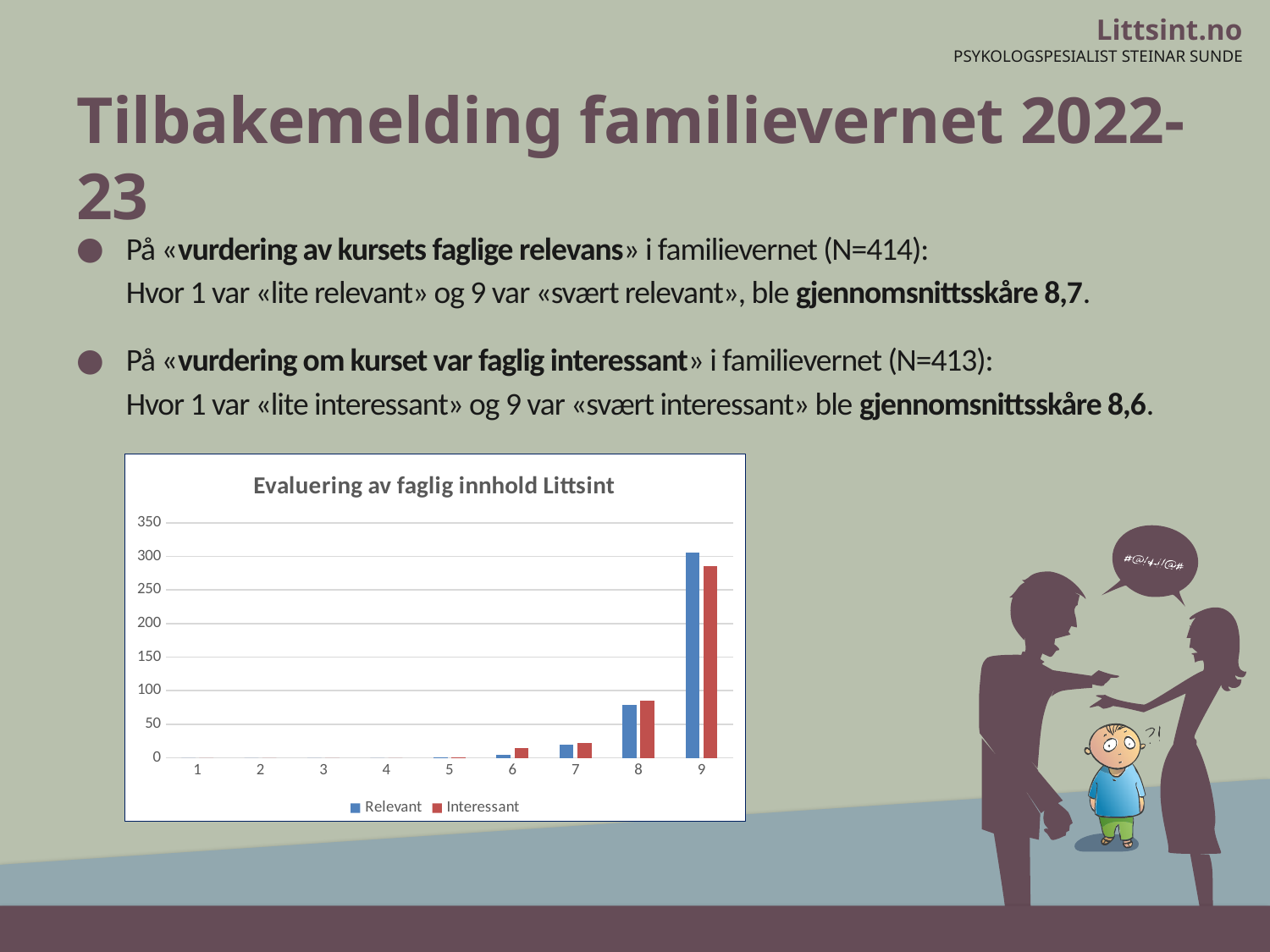
Do the values generally rise or fall as you move from category 1 to category 9? rise At category 6, which series has the larger value, Relevant or Interessant? Interessant Which category has the highest value for the Relevant series? 9 Which category has the highest value for the Interessant series? 9 Is the value for Interessant at category 9 greater or less than 300? less At category 9, which series has the larger value, Relevant or Interessant? Relevant How many series does the chart legend list? 2 How many categories are shown on the x axis of the chart? 9 Is the value for Relevant at category 8 greater or less than 100? less What is the title of the chart? Evaluering av faglig innhold Littsint What kind of chart is shown on the slide? bar chart Is the value for Relevant at category 9 greater or less than 250? greater